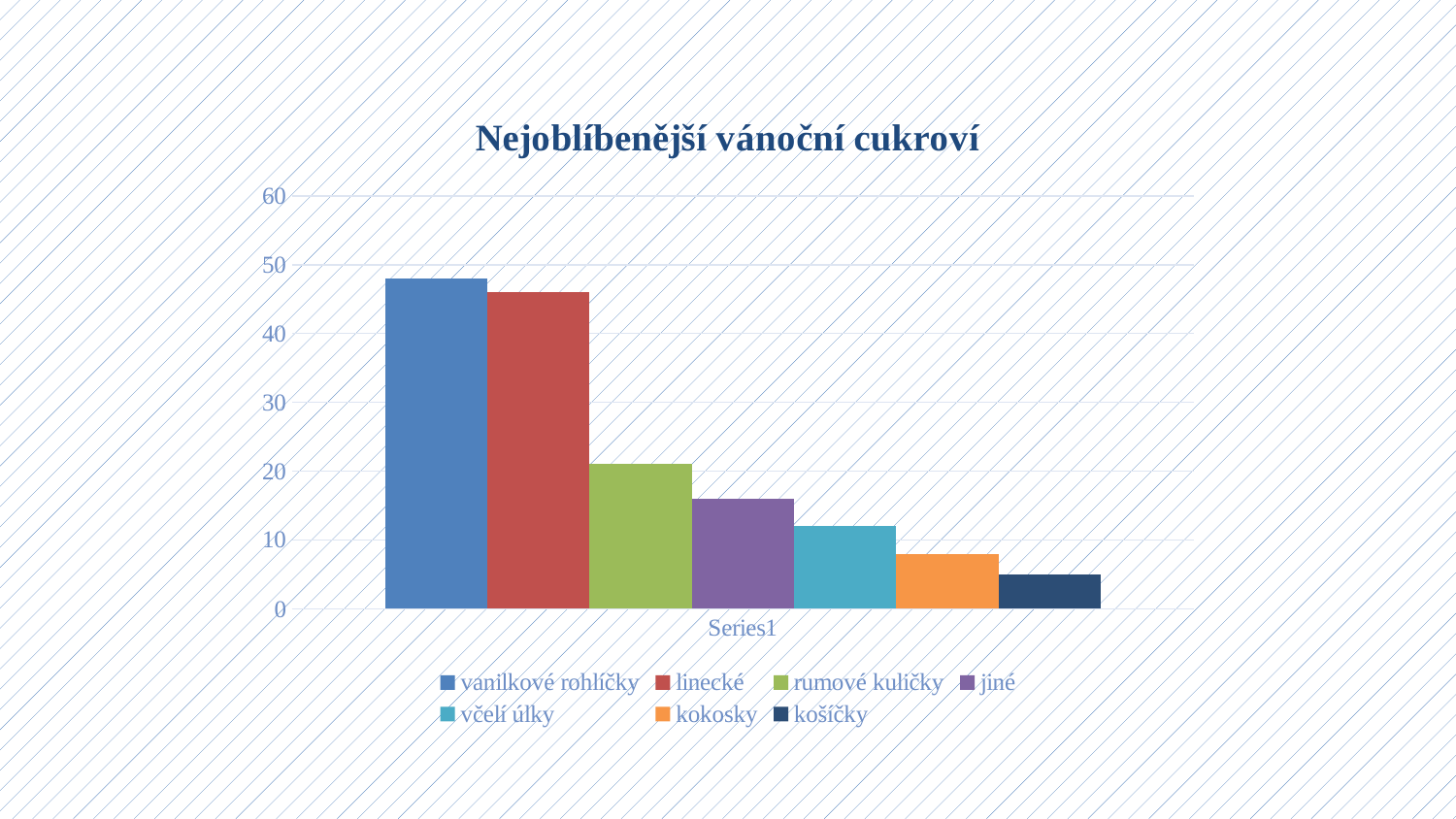
Which series has the highest bar? vanilkové rohlíčky Which is larger, the value for rumové kuličky or the value for jiné? rumové kuličky Is the value for kokosky greater or less than 10? less What is the title of the chart? Nejoblíbenější vánoční cukroví How many series does the legend list? 7 Do the bar values rise or fall from left to right across the chart? fall Is the value for rumové kuličky greater or less than 30? less Is the value for linecké greater or less than 40? greater What kind of chart is shown on the slide? bar chart How many bars are plotted in the chart? 7 Which series has the lowest bar? košíčky